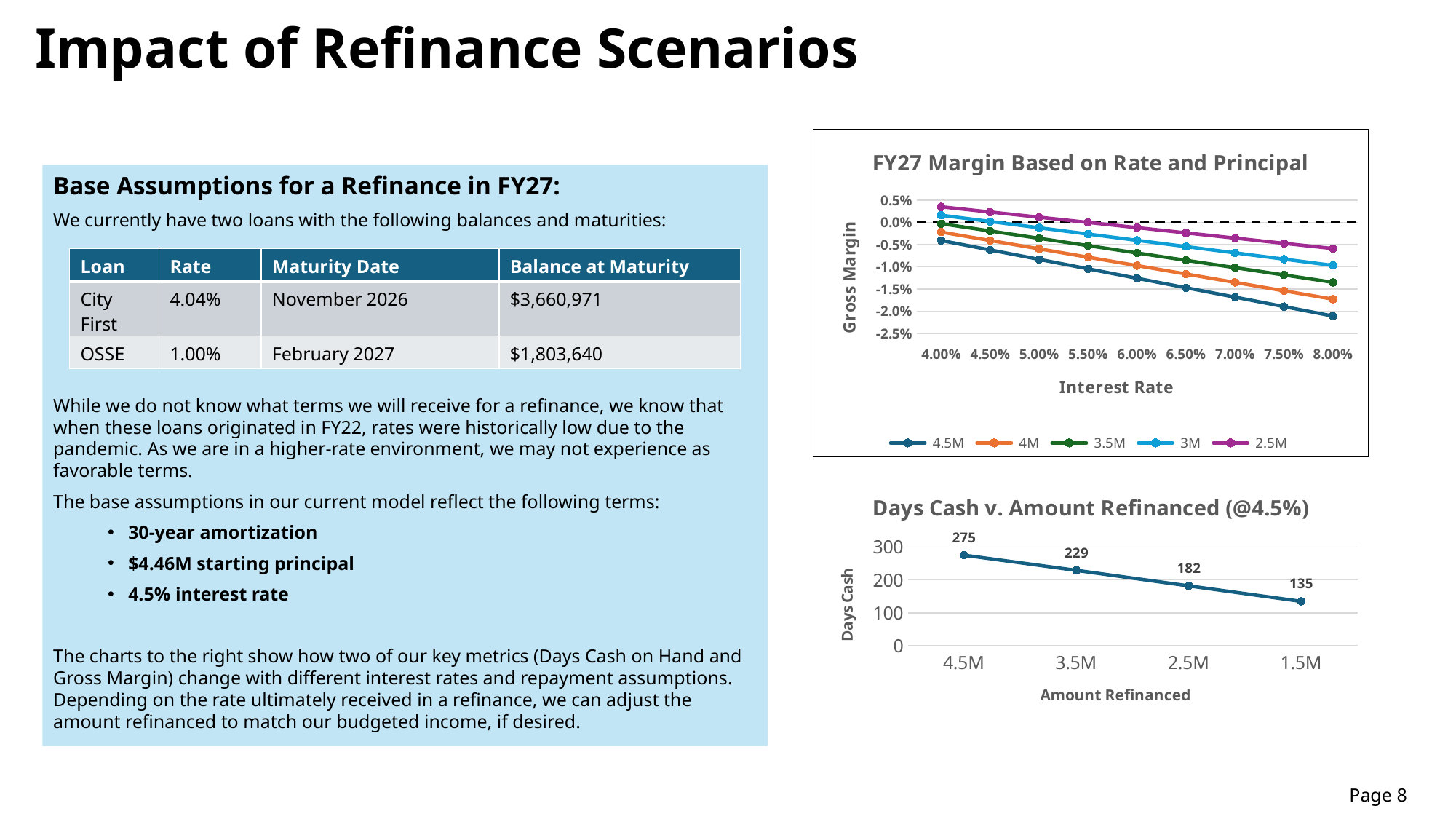
In the 'Days Cash v. Amount Refinanced (@4.5%)' chart, what is the Days Cash value when the amount refinanced is 4.5M? 275 In the 'Days Cash v. Amount Refinanced (@4.5%)' chart, do the values rise or fall from left to right along the x axis? fall In the 'Days Cash v. Amount Refinanced (@4.5%)' chart, which amount refinanced gives the highest Days Cash? 4.5M In the 'FY27 Margin Based on Rate and Principal' chart, how many interest rate values are shown on the x axis? 9 What kind of chart is 'FY27 Margin Based on Rate and Principal'? line chart In the 'Days Cash v. Amount Refinanced (@4.5%)' chart, what is the Days Cash value when the amount refinanced is 1.5M? 135 In the 'FY27 Margin Based on Rate and Principal' chart, is the gross margin for the 2.5M series at 4.00% greater or less than 0.0%? greater In the 'FY27 Margin Based on Rate and Principal' chart, at an 8.00% interest rate, which series has the higher gross margin: 2.5M or 4.5M? 2.5M In the 'FY27 Margin Based on Rate and Principal' chart, how many series does the legend list? 5 In the 'Days Cash v. Amount Refinanced (@4.5%)' chart, what is the difference in Days Cash between 4.5M and 1.5M refinanced? 140 In the 'Days Cash v. Amount Refinanced (@4.5%)' chart, how many data points are plotted? 4 In the 'Days Cash v. Amount Refinanced (@4.5%)' chart, what is the difference in Days Cash between 3.5M and 2.5M refinanced? 47